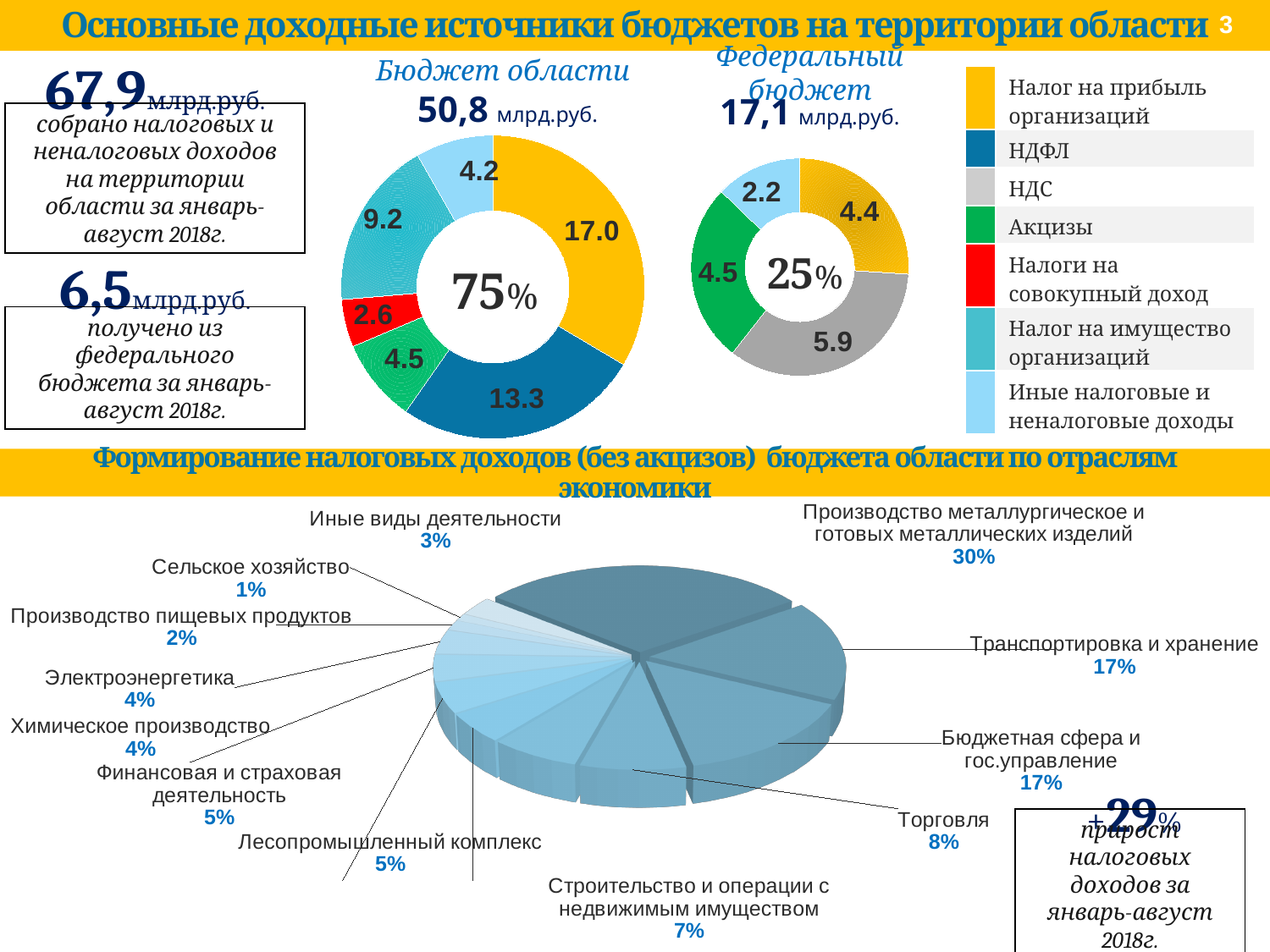
What percentage is shown in the centre of the 'Федеральный бюджет' donut chart? 25% On the 'Бюджет области' donut chart, what is the value for 'Налог на прибыль организаций' (yellow segment)? 17.0 On the 'Федеральный бюджет' donut chart, which category has the highest value? НДС On the 'Бюджет области' donut chart, which category has the lowest value? Налоги на совокупный доход On the 'Бюджет области' donut chart, what is the value for 'НДФЛ' (dark blue segment)? 13.3 On the bottom pie chart of tax revenues by industry, how many categories are shown? 12 On the 'Федеральный бюджет' donut chart, how many segments are there? 4 Which is larger: 'Акцизы' on the 'Бюджет области' chart or 'Акцизы' on the 'Федеральный бюджет' chart? They are equal (4.5) On the bottom pie chart of tax revenues by industry, what share does 'Производство металлургическое и готовых металлических изделий' have? 30% On the bottom pie chart of tax revenues by industry, which category has the smallest share? Сельское хозяйство On the 'Федеральный бюджет' donut chart, what is the value for 'НДС' (grey segment)? 5.9 On the 'Бюджет области' donut chart, what is the difference between 'Налог на имущество организаций' and 'Акцизы'? 4.7